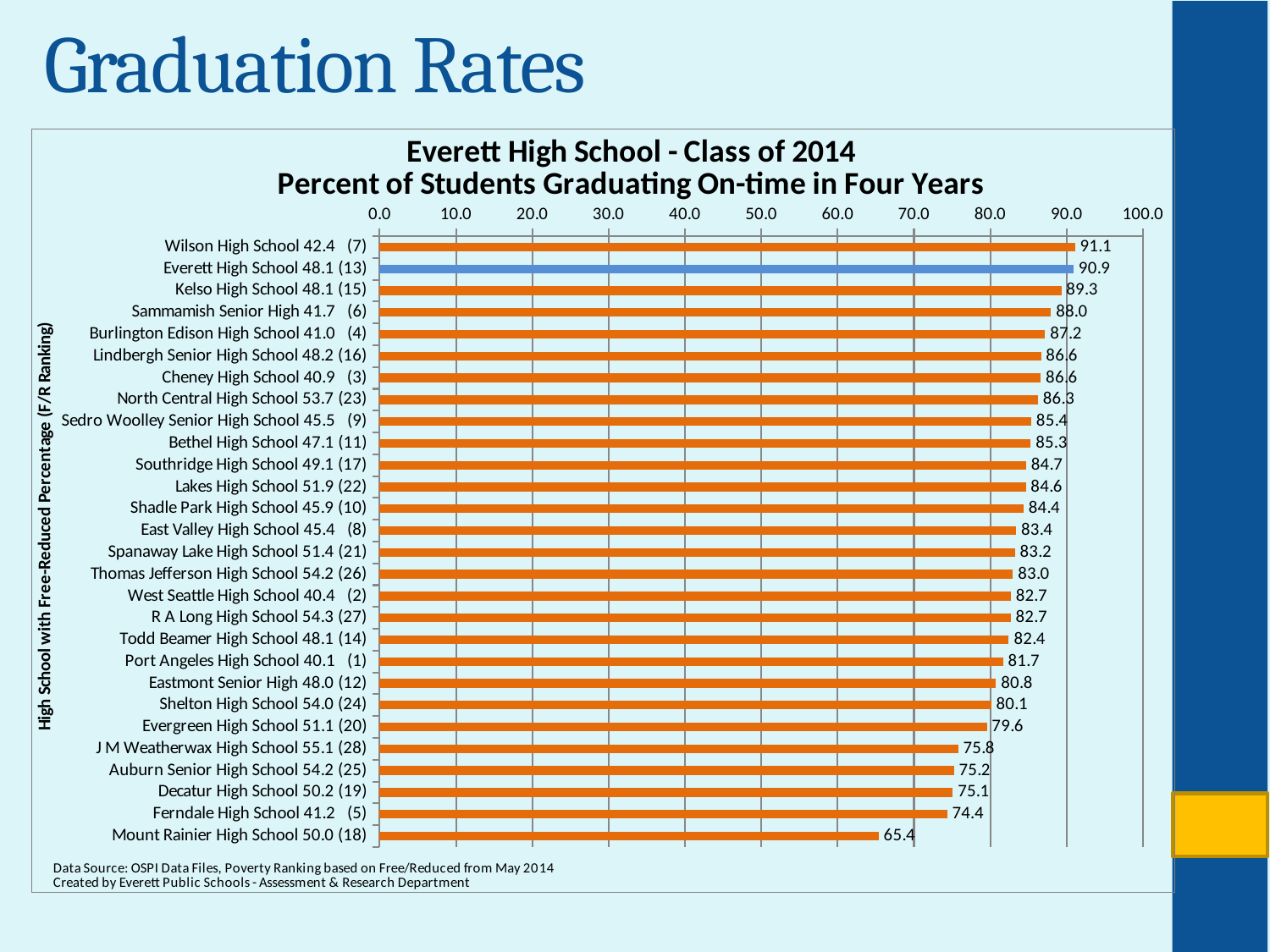
What is the on-time graduation rate shown for Everett High School? 90.9 What value is shown for Cheney High School? 86.6 What is the difference between the values for Everett High School and Mount Rainier High School? 25.5 How many high schools are shown on the chart? 28 Which high school has the highest graduation rate on the chart? Wilson High School Which has a higher graduation rate, Kelso High School or Shelton High School? Kelso High School Is the value for Ferndale High School greater or less than 80.0? less What is the difference between the values for Wilson High School and Everett High School? 0.2 Which high school has the lowest graduation rate on the chart? Mount Rainier High School Which high school's bar is shown in a different colour (blue) from the others? Everett High School What kind of chart is shown on the slide? Bar chart What value is shown for Mount Rainier High School? 65.4